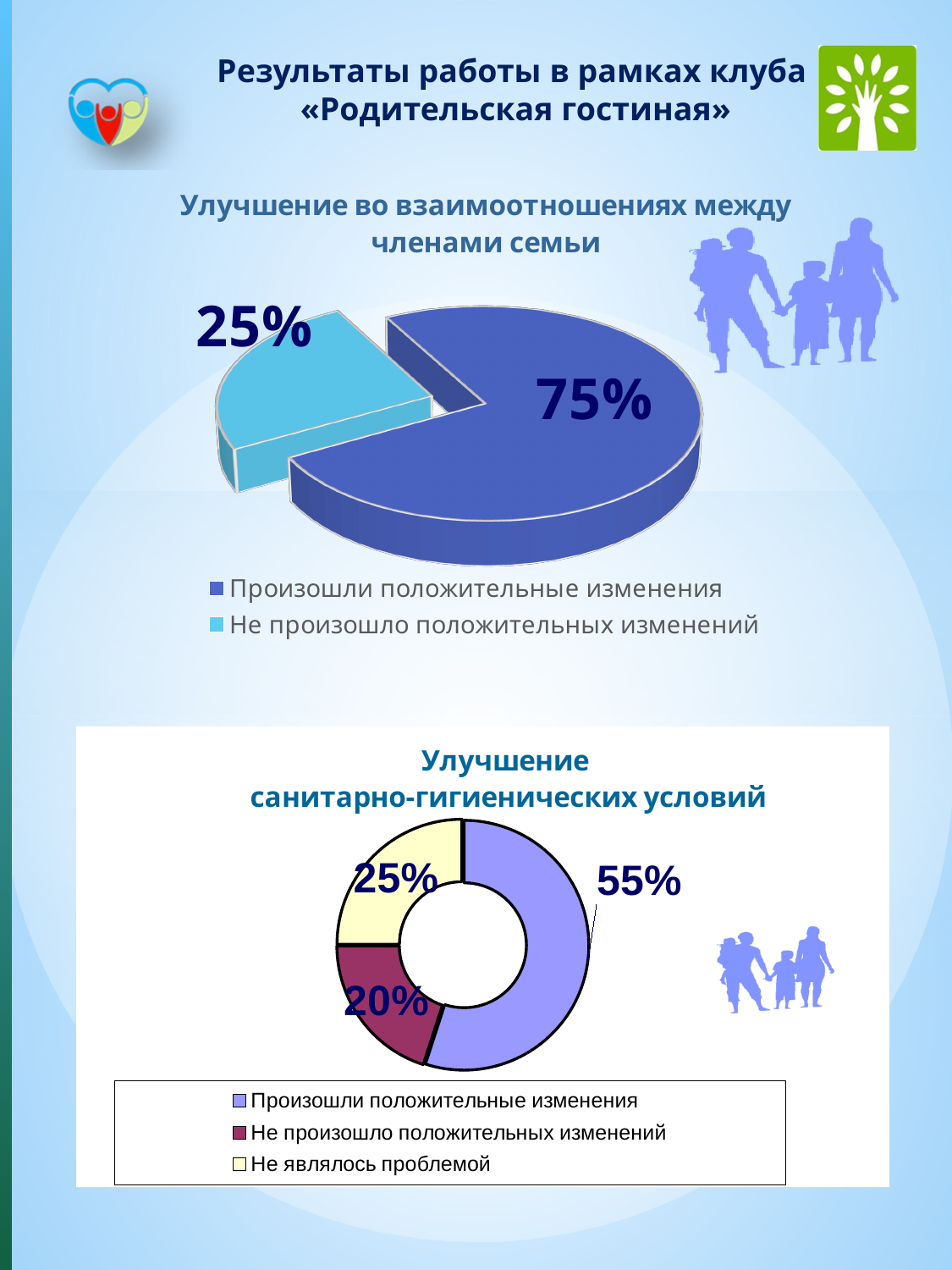
In the chart titled «Улучшение санитарно-гигиенических условий», what share is labelled for «Произошли положительные изменения»? 55% In the chart titled «Улучшение во взаимоотношениях между членами семьи», which category has the largest slice? Произошли положительные изменения What kind of chart is the top chart, «Улучшение во взаимоотношениях между членами семьи»? Pie chart In the chart titled «Улучшение санитарно-гигиенических условий», what share is labelled for «Не являлось проблемой»? 25% In the chart titled «Улучшение во взаимоотношениях между членами семьи», what share is labelled for «Не произошло положительных изменений»? 25% In the chart titled «Улучшение санитарно-гигиенических условий», which is larger: «Не являлось проблемой» or «Не произошло положительных изменений»? Не являлось проблемой In the chart titled «Улучшение санитарно-гигиенических условий», what share is labelled for «Не произошло положительных изменений»? 20% How many entries does the legend of the top chart, «Улучшение во взаимоотношениях между членами семьи», list? 2 In the chart titled «Улучшение санитарно-гигиенических условий», which category has the smallest slice? Не произошло положительных изменений In the chart titled «Улучшение во взаимоотношениях между членами семьи», what share is labelled for «Произошли положительные изменения»? 75% In the chart titled «Улучшение санитарно-гигиенических условий», how many categories are shown? 3 In the chart titled «Улучшение во взаимоотношениях между членами семьи», what is the difference between the two slices? 50%